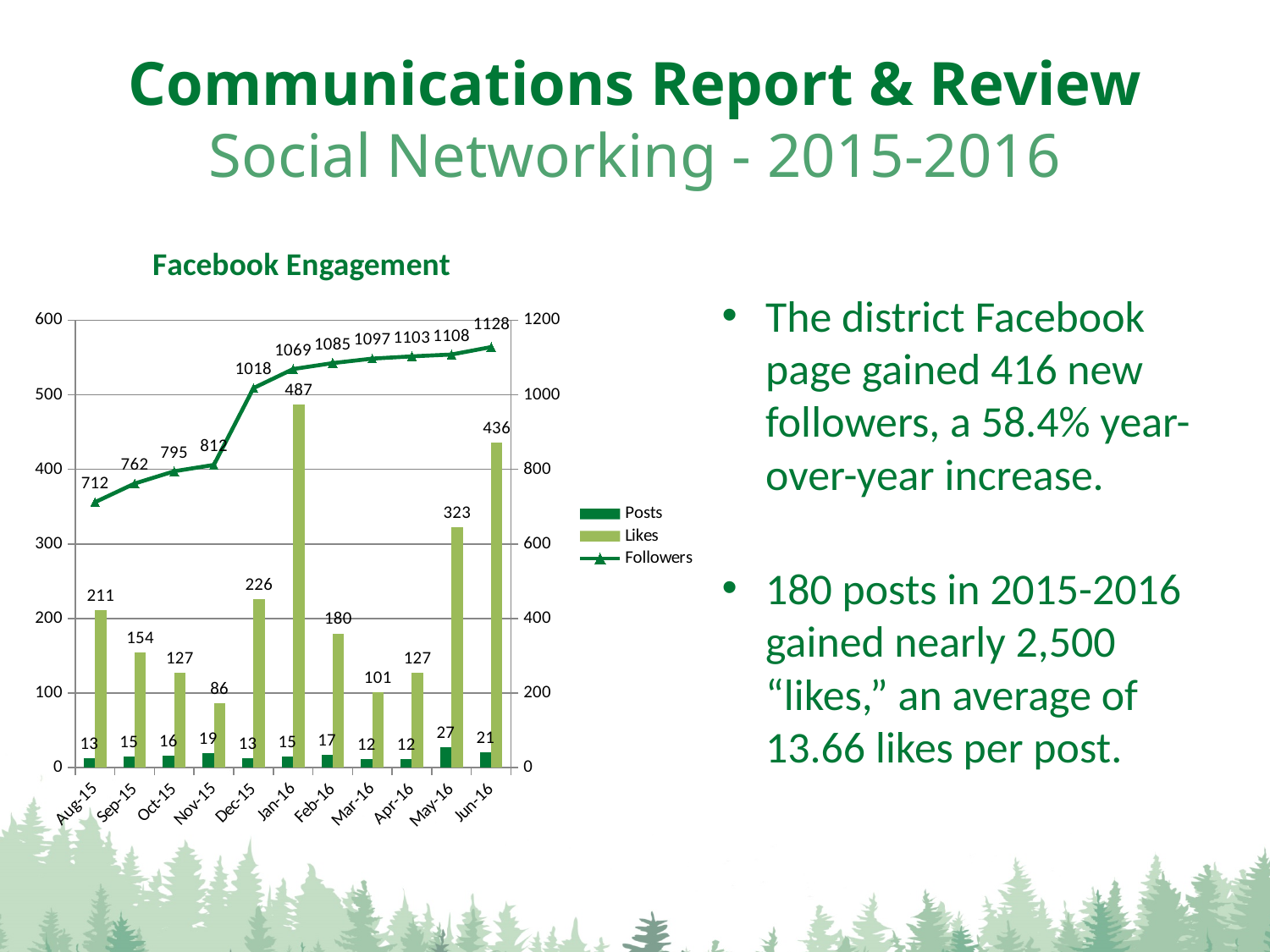
Which month has the highest Likes value? Jan-16 What is the difference between the Followers values for Jun-16 and Aug-15? 416 What is the Followers value for Aug-15? 712 Do the Followers values rise or fall from Aug-15 to Jun-16? rise How many months are shown on the x axis of the chart? 11 What is the title of the chart? Facebook Engagement Which is larger, the Likes value for Dec-15 or for Feb-16? Dec-15 What is the Likes value for Jan-16? 487 What is the Posts value for May-16? 27 Which month has the lowest Likes value? Nov-15 Which series is plotted as a line with triangle markers? Followers How many series does the chart's legend list? 3